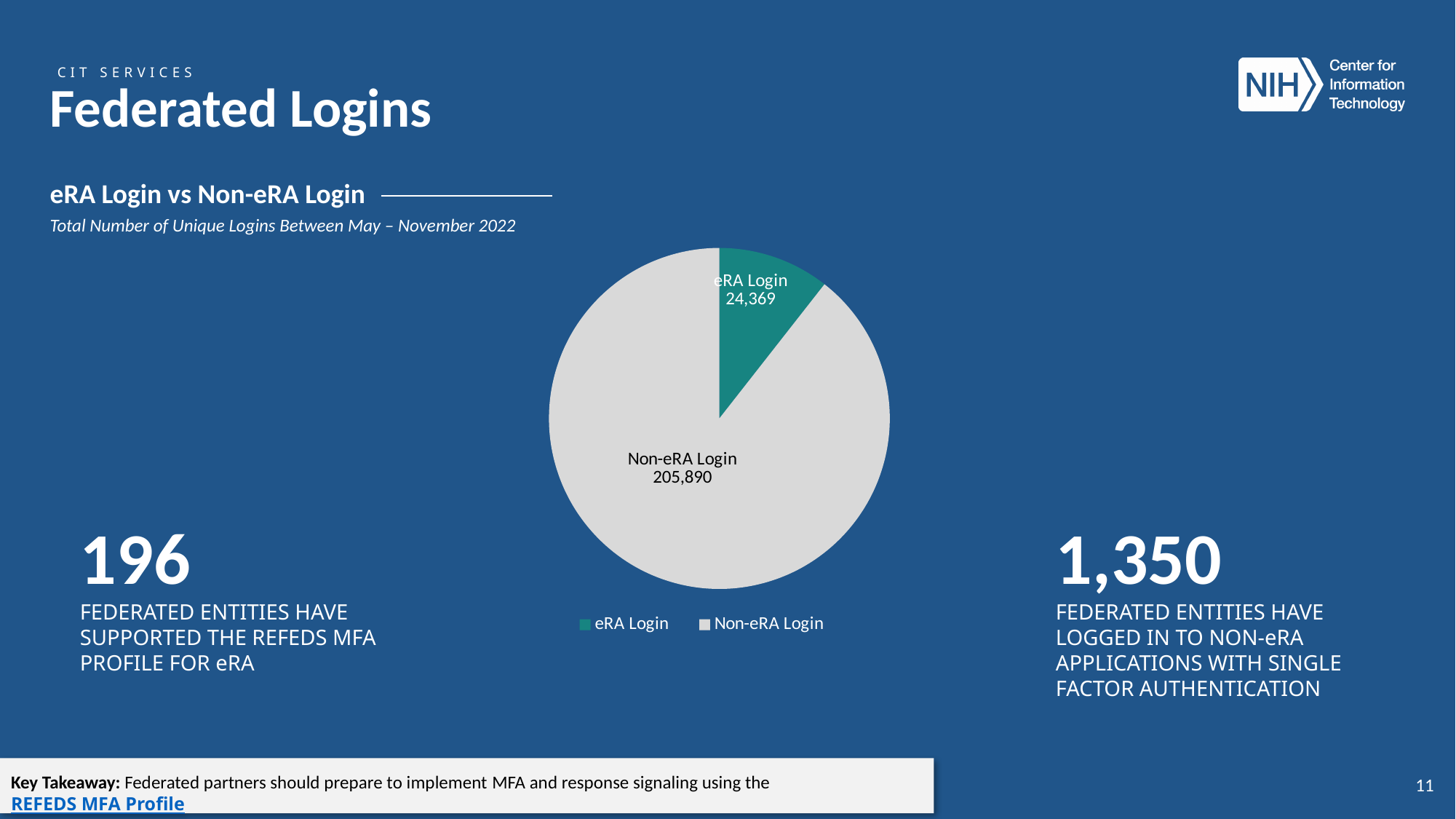
What is the title of the chart section on the slide? eRA Login vs Non-eRA Login What is the value for eRA Login in the pie chart? 24,369 What kind of chart is shown on the slide? Pie chart What is the value for Non-eRA Login in the pie chart? 205,890 Which category has the largest slice in the pie chart? Non-eRA Login What is the difference between the Non-eRA Login and eRA Login values? 181,521 Which is larger, eRA Login or Non-eRA Login? Non-eRA Login Which category has the smallest slice in the pie chart? eRA Login What is the total of the two values shown in the pie chart? 230,259 How many entries does the chart legend list? 2 How many categories are shown in the pie chart? 2 What colour is the eRA Login slice in the pie chart? Green (teal)